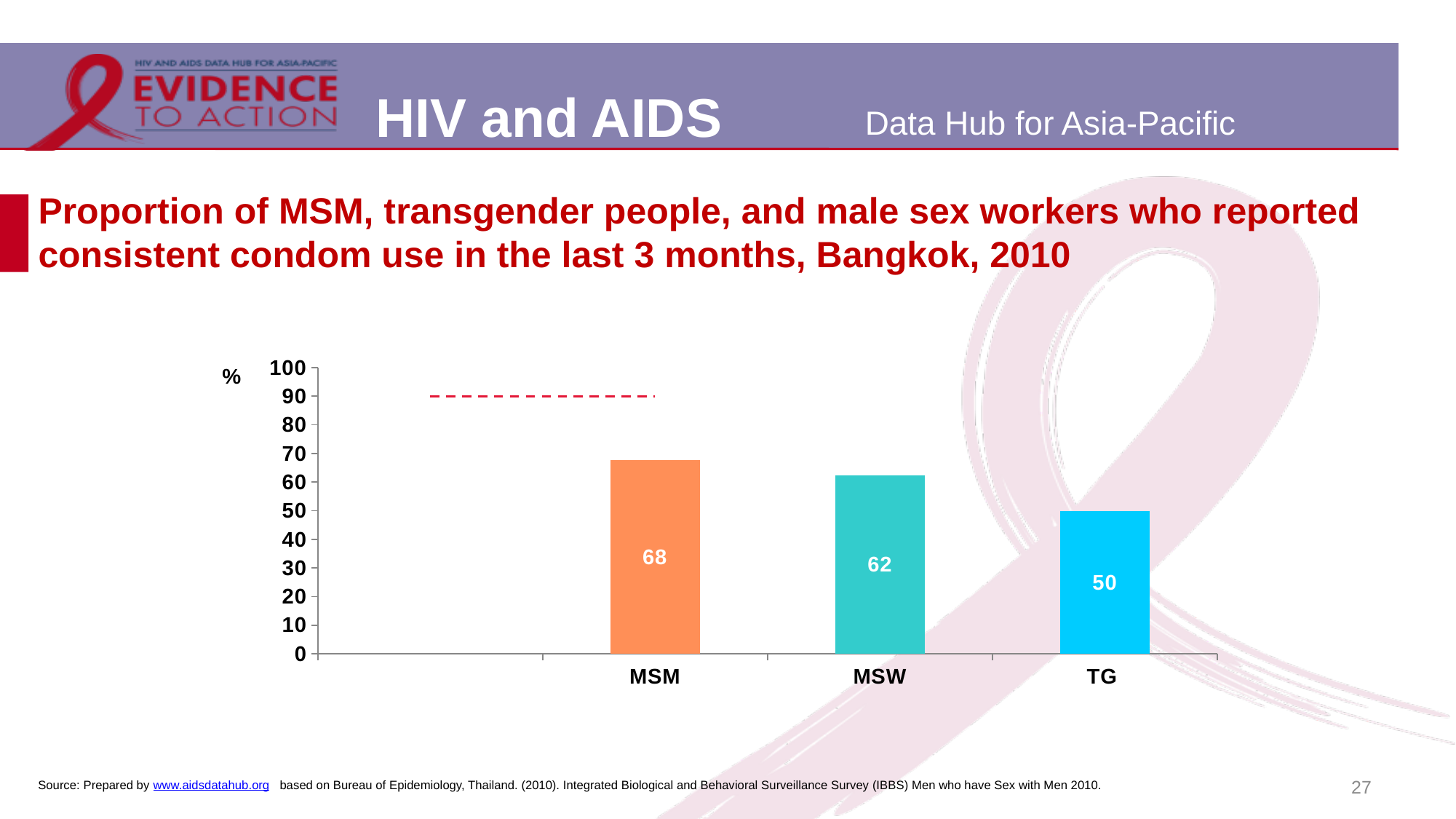
What is the value for MSW? 62 What unit is shown on the y axis label? % What is the value for MSM? 68 What is the difference between the values for MSM and TG? 18 Which category has the lowest value? TG How many categories are shown on the x axis? 3 Which is larger, the value for MSW or the value for TG? MSW What is the difference between the values for MSM and MSW? 6 Is the value for MSW greater or less than 70? less What kind of chart is shown on the slide? bar chart What is the value for TG? 50 Which category has the highest value? MSM